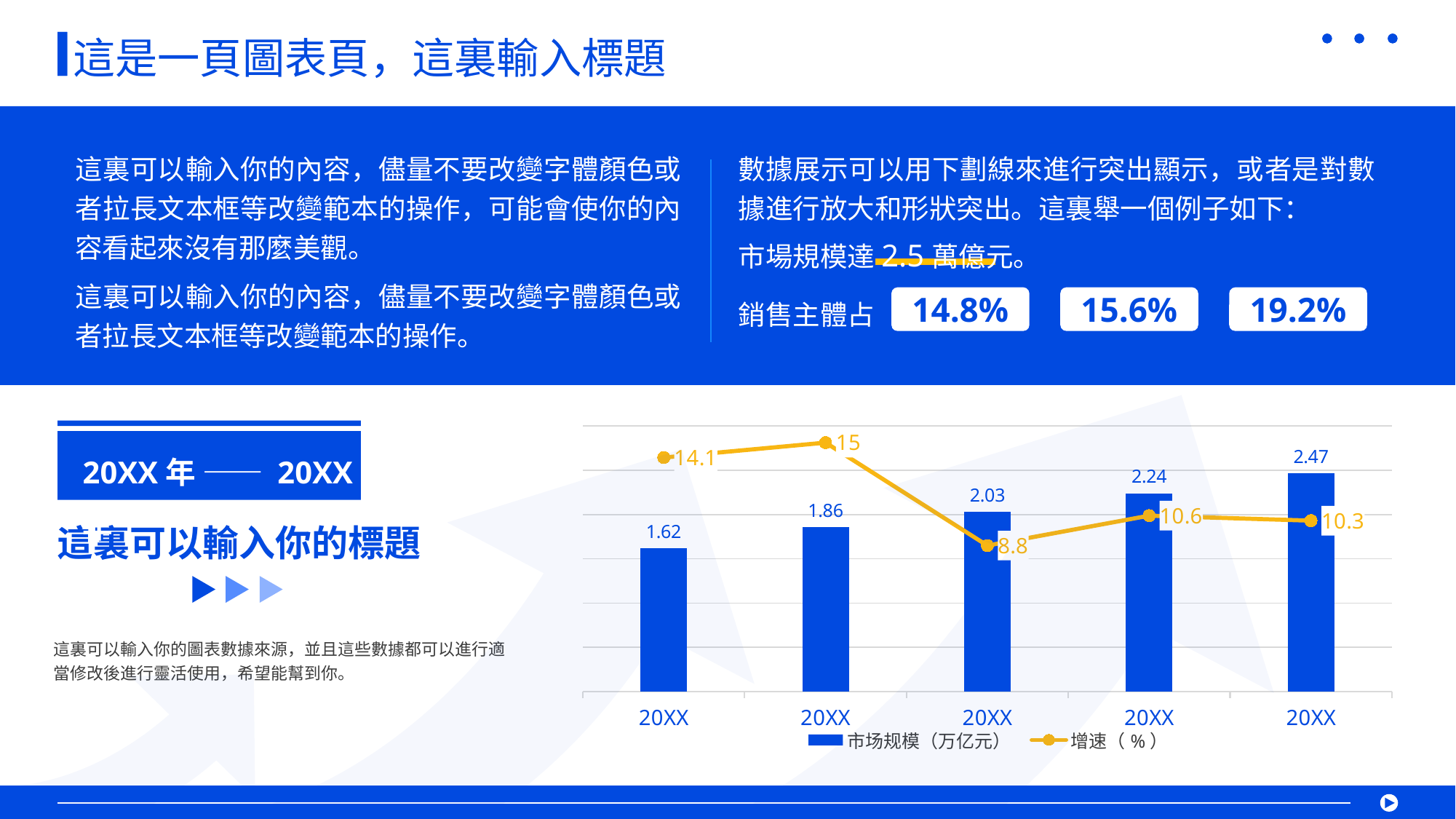
How many series does the legend list? 2 What is the 增速（%） value at the third point from the left? 8.8 What is the value of the first (leftmost) bar for 市场规模（万亿元）? 1.62 What is the 增速（%） value at the second point from the left? 15 How many bars are plotted in the chart? 5 Do the 市场规模（万亿元） bar values rise or fall from left to right? Rise What is the difference between the 市场规模 values of the fourth and third bars? 0.21 Which bar has the highest 市场规模（万亿元） value? The rightmost (fifth) bar, 2.47 Which is larger: the 增速（%） value at the fourth point (10.6) or at the fifth point (10.3)? The fourth point, 10.6 What is the value of the rightmost bar for 市场规模（万亿元）? 2.47 Which point on the 增速（%） line is the lowest? The third point, 8.8 What kind of chart is shown on the slide? A combined bar and line chart